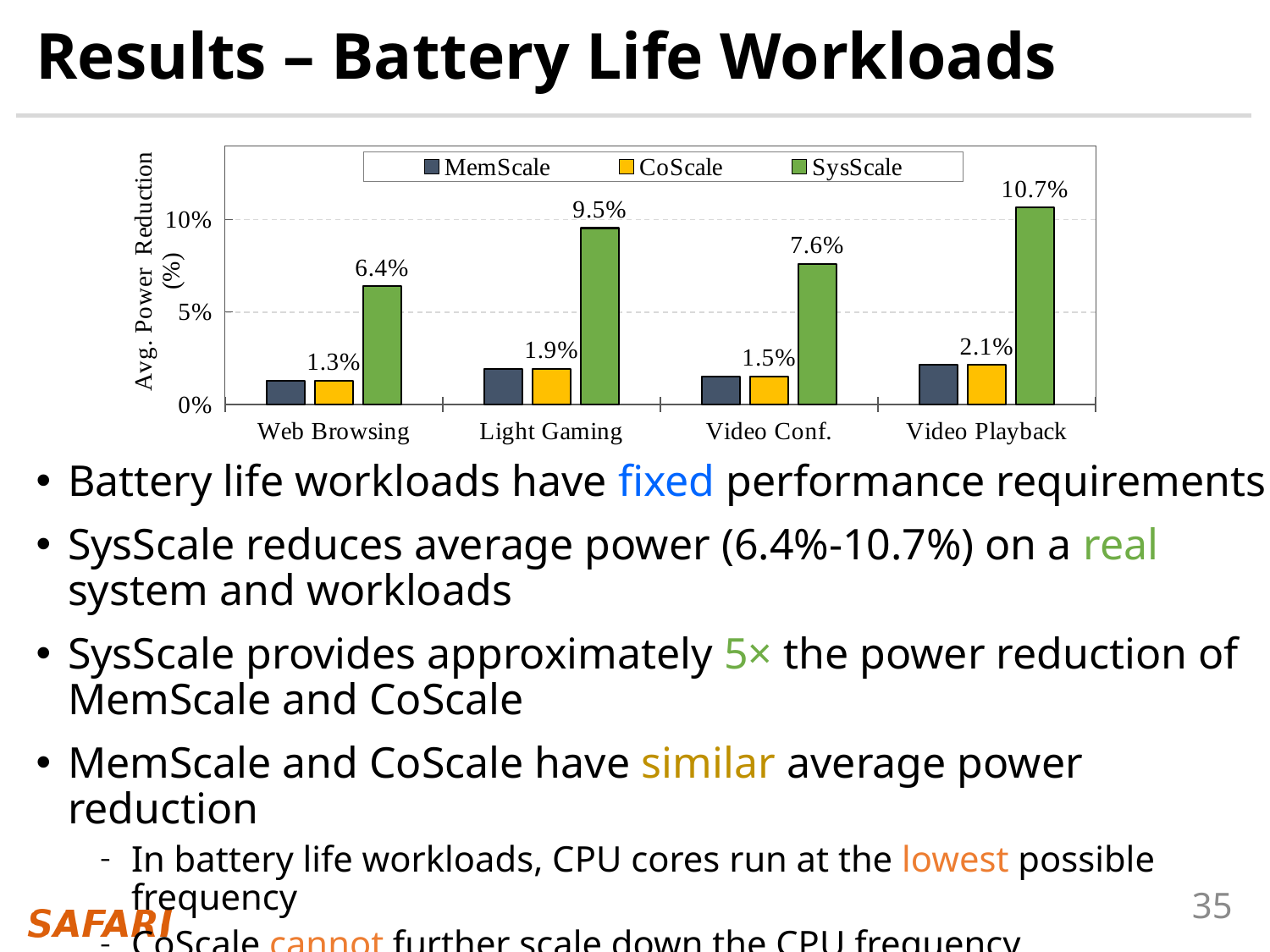
Which workload has a larger SysScale power reduction, Light Gaming or Video Conf.? Light Gaming What is the difference between SysScale's power reduction in Video Playback and in Web Browsing? 4.3% Is the MemScale value for Video Playback greater or less than 5%? less In which workload does SysScale achieve its highest average power reduction? Video Playback What is the average power reduction for SysScale in Video Conf.? 7.6% What is the average power reduction for SysScale in Video Playback? 10.7% What is the average power reduction for SysScale in Light Gaming? 9.5% In which workload does SysScale achieve its lowest average power reduction? Web Browsing What is the average power reduction for SysScale in Web Browsing? 6.4% How many workload categories are shown on the x axis? 4 What kind of chart is shown on the slide? bar chart How many series does the chart legend list? 3